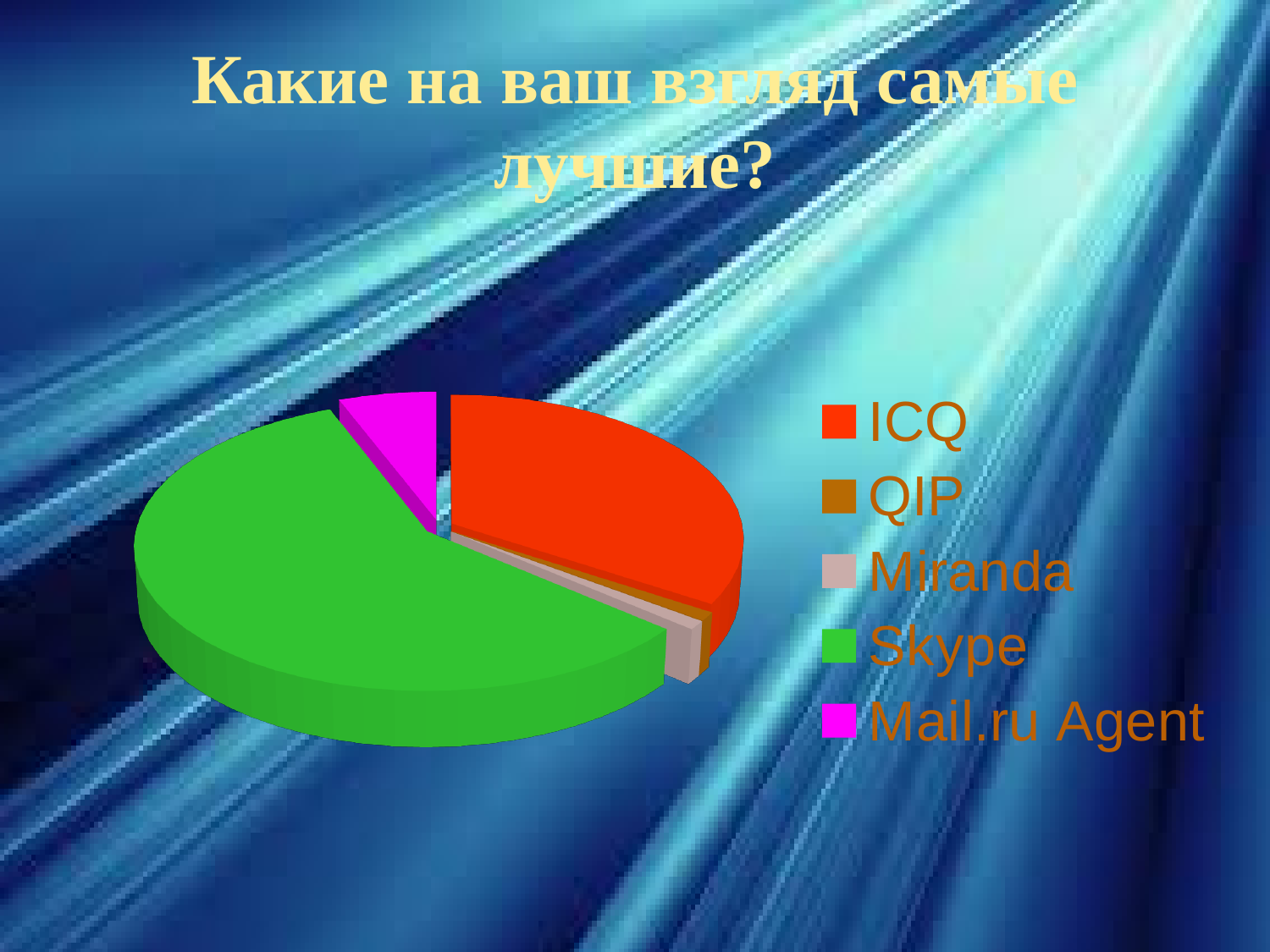
Which slice is larger, Mail.ru Agent or QIP? Mail.ru Agent What kind of chart is shown on the slide? pie chart Which slice is larger, Skype or Mail.ru Agent? Skype What is the title of the slide above the pie chart? Какие на ваш взгляд самые лучшие? Which slice is larger, ICQ or Mail.ru Agent? ICQ Which category has the largest slice of the pie chart? Skype What colour is the Skype slice in the pie chart? green How many categories does the pie chart have? 5